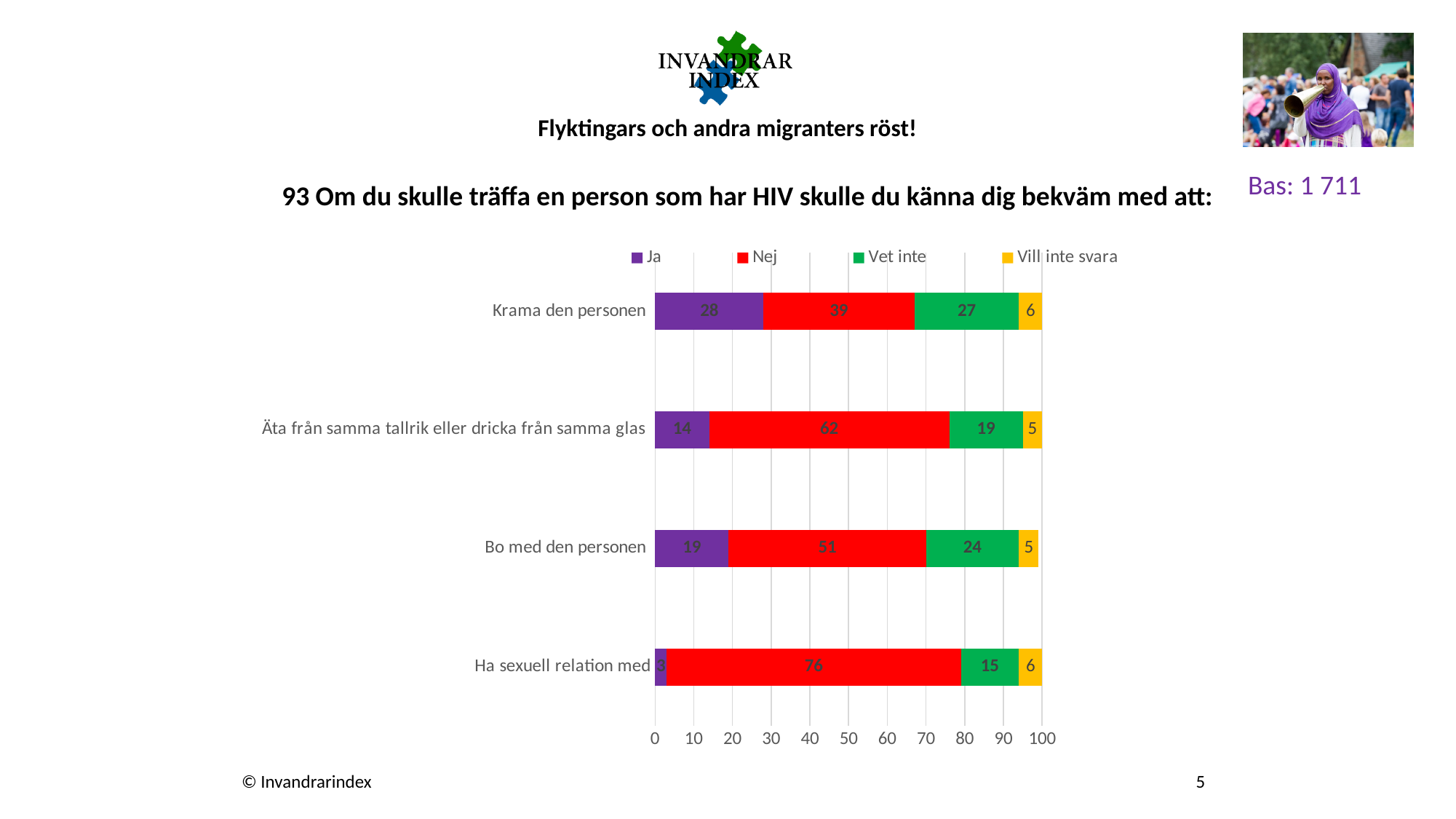
What is the "Ja" value for "Ha sexuell relation med"? 3 What is the "Vill inte svara" value for "Äta från samma tallrik eller dricka från samma glas"? 5 How many series does the legend list? 4 What kind of chart is shown on the slide? Stacked bar chart How many categories are shown in the chart? 4 What is the difference between the "Nej" values for "Ha sexuell relation med" and "Krama den personen"? 37 Which is larger: the "Ja" value for "Krama den personen" or the "Ja" value for "Bo med den personen"? Krama den personen What is the "Nej" value for "Krama den personen"? 39 Which category has the lowest "Ja" value? Ha sexuell relation med Which category has the highest "Nej" value? Ha sexuell relation med What is the "Vet inte" value for "Bo med den personen"? 24 What is the total of the stacked bar for "Bo med den personen"? 99